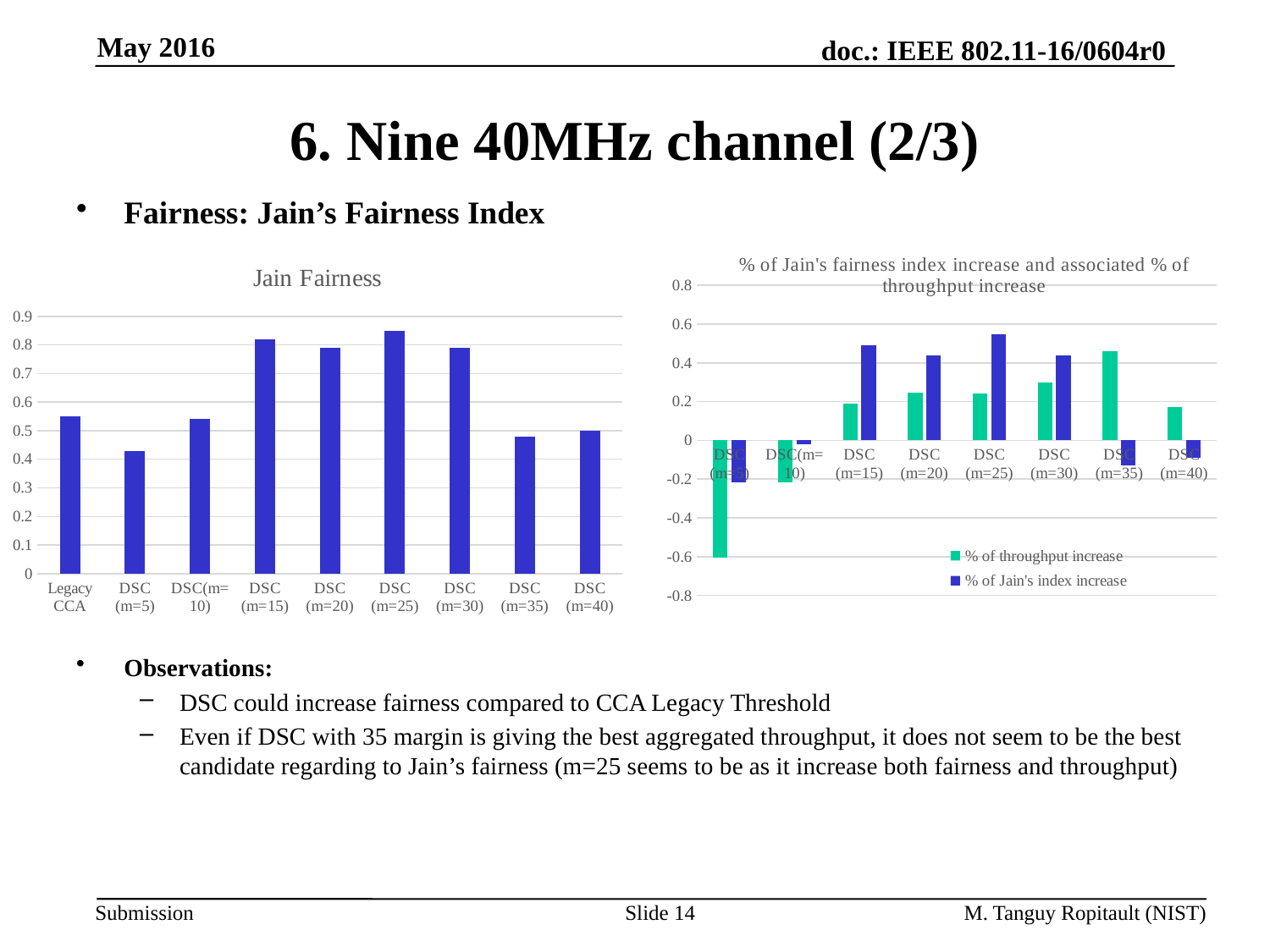
In the chart on the right, is the % of throughput increase for DSC (m=35) greater or less than 0.4? greater In the chart on the right, which is larger for DSC (m=15): the % of throughput increase or the % of Jain's index increase? % of Jain's index increase In the chart on the right, which category has the lowest % of throughput increase? DSC (m=5) What kind of chart is the Jain Fairness chart? bar chart How many categories are shown on the x axis of the Jain Fairness chart? 9 How many series does the legend list in the chart titled '% of Jain's fairness index increase and associated % of throughput increase'? 2 In the Jain Fairness chart, which category has the lowest value? DSC (m=5) In the chart on the right, which category has the highest % of Jain's index increase? DSC (m=25) In the Jain Fairness chart, which category has the highest value? DSC (m=25) In the Jain Fairness chart, which is larger: the value for Legacy CCA or the value for DSC (m=5)? Legacy CCA